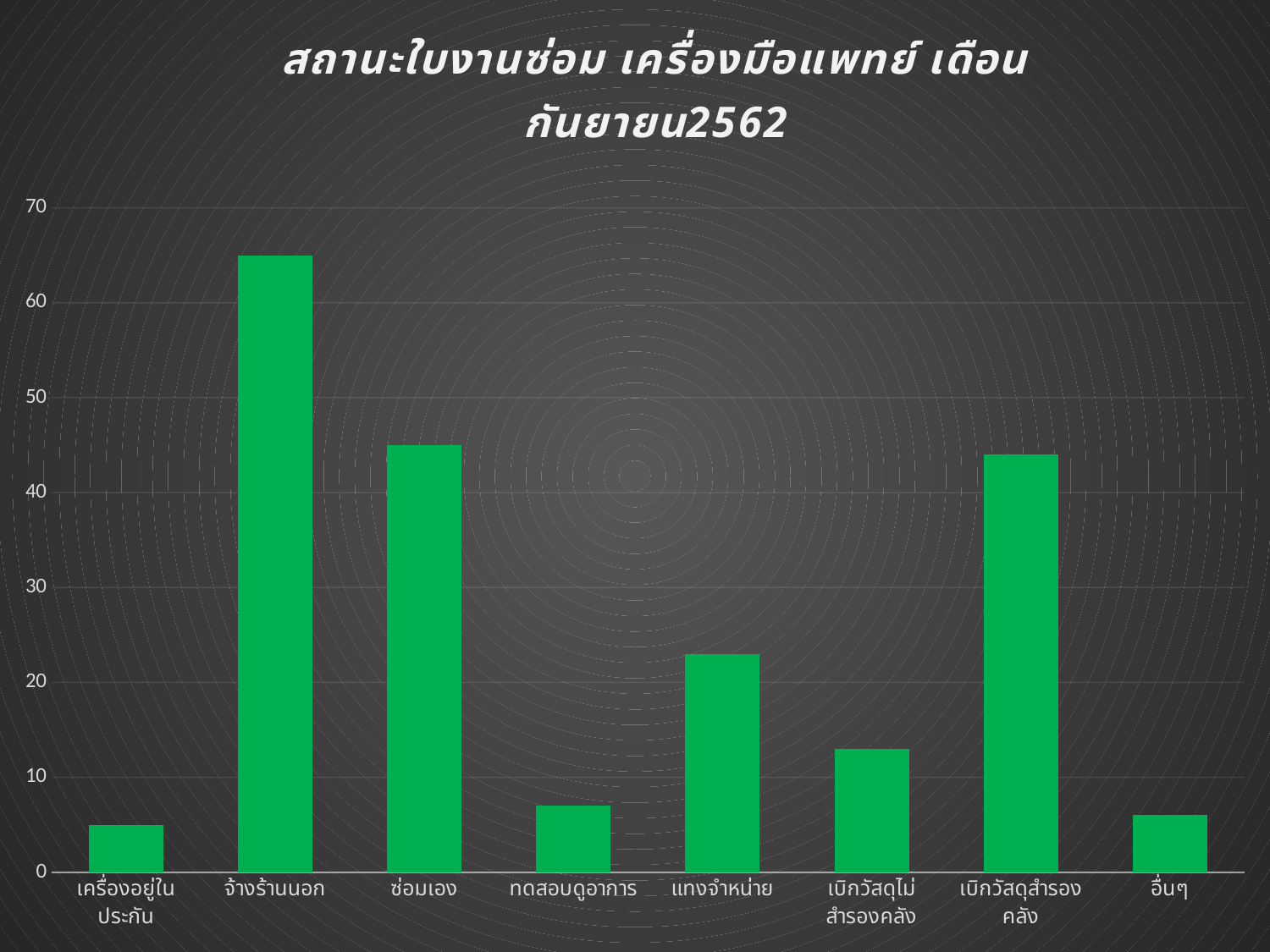
Which category has the highest bar in the chart? จ้างร้านนอก Which is larger, the value for แทงจำหน่าย or the value for เบิกวัสดุไม่สำรองคลัง? แทงจำหน่าย Is the value for แทงจำหน่าย greater or less than 20? greater What colour are the bars in the chart? green Is the value for ซ่อมเอง greater or less than 40? greater Which is larger, the value for ซ่อมเอง or the value for ทดสอบดูอาการ? ซ่อมเอง What kind of chart is shown on the slide? bar chart Is the value for เบิกวัสดุไม่สำรองคลัง greater or less than 20? less How many categories are shown on the x axis of the chart? 8